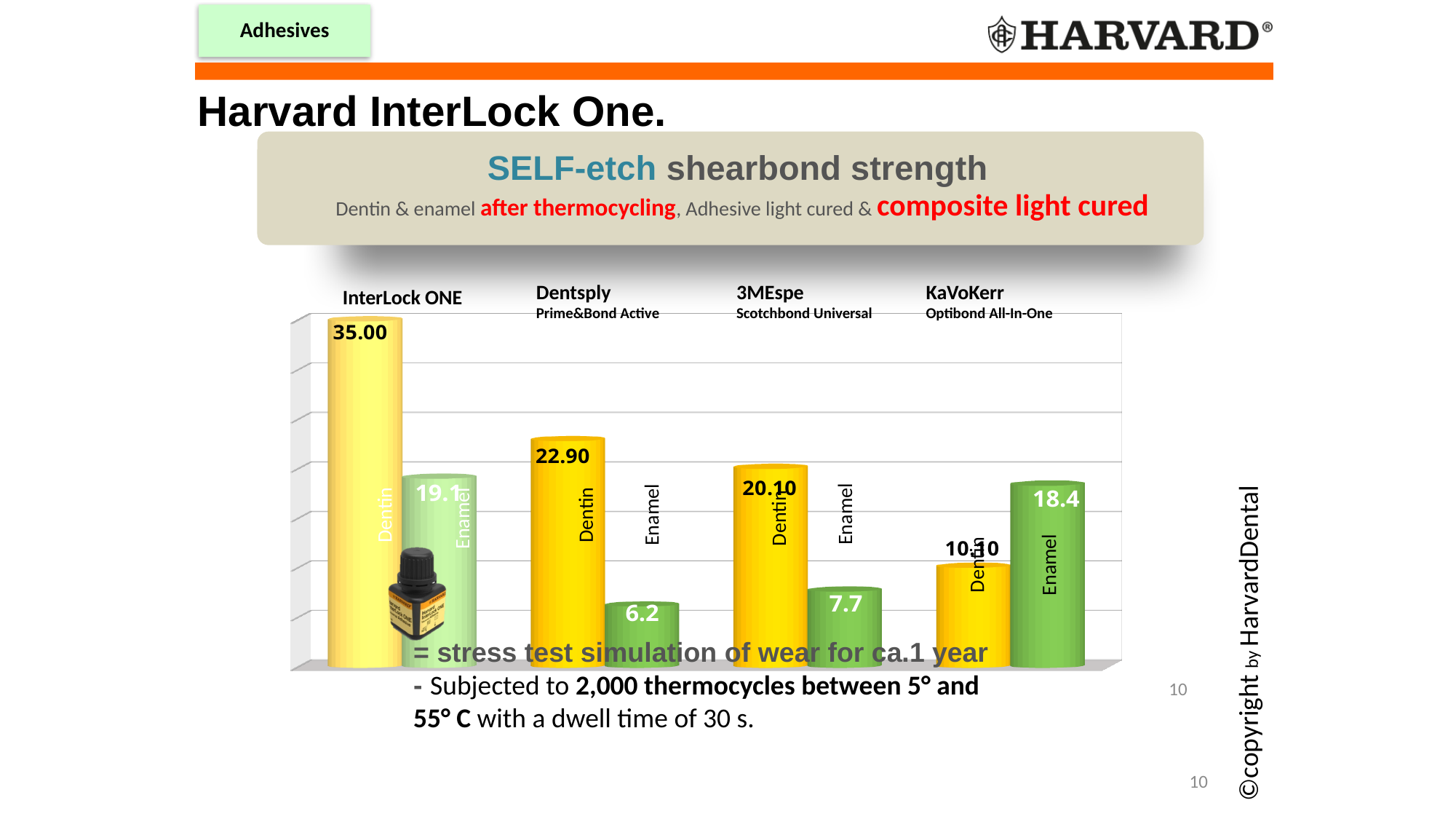
Which product has the lowest Enamel value? Dentsply Prime&Bond Active What is the Enamel value for KaVoKerr Optibond All-In-One? 18.4 What colour are the Enamel bars in the chart? Green Which is larger for KaVoKerr Optibond All-In-One, the Dentin value or the Enamel value? Enamel What is the Dentin value for 3MEspe Scotchbond Universal? 20.10 What kind of chart is shown on the slide? Bar chart What is the Dentin shearbond strength value for InterLock ONE? 35.00 What is the difference between the Enamel values of InterLock ONE and 3MEspe Scotchbond Universal? 11.4 How many products are compared in the chart? 4 What is the Enamel value for Dentsply Prime&Bond Active? 6.2 What is the difference between the Dentin values of InterLock ONE and Dentsply Prime&Bond Active? 12.10 Which product has the highest Dentin value? InterLock ONE